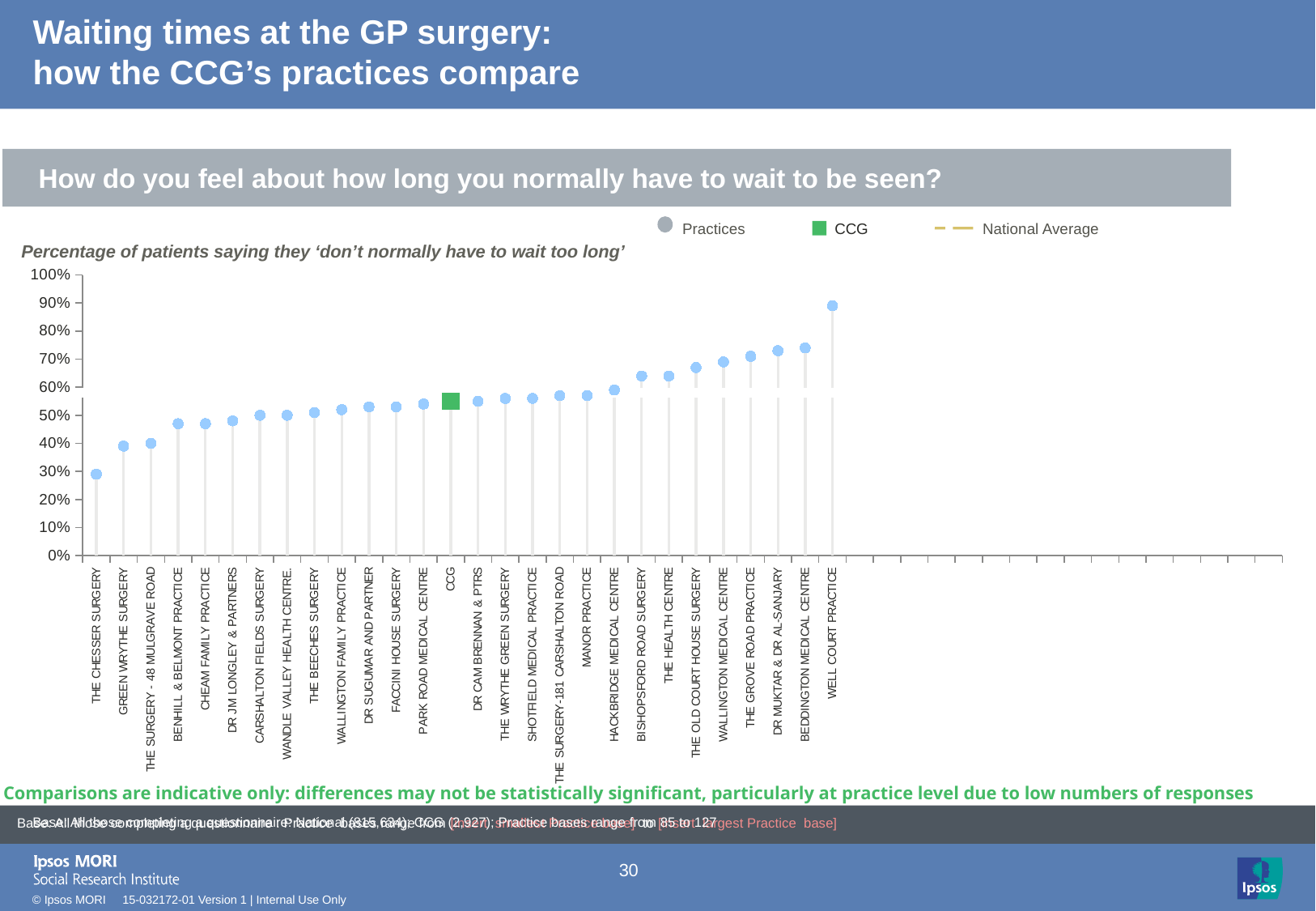
Is the value for BEDDINGTON MEDICAL CENTRE greater or less than 70%? greater Is the value for THE CHESSER SURGERY greater or less than 40%? less Do the values rise or fall moving from left to right along the x axis? rise Is the value for WELL COURT PRACTICE greater or less than 80%? greater How many practices (excluding the CCG marker) are plotted on the chart? 27 Which has a lower value, BISHOPSFORD ROAD SURGERY or BENHILL & BELMONT PRACTICE? BENHILL & BELMONT PRACTICE Which practice has the highest percentage of patients saying they 'don't normally have to wait too long'? WELL COURT PRACTICE How many entries does the legend list? 3 Which practice has the lowest percentage of patients saying they 'don't normally have to wait too long'? THE CHESSER SURGERY Which has a higher value, THE GROVE ROAD PRACTICE or PARK ROAD MEDICAL CENTRE? THE GROVE ROAD PRACTICE